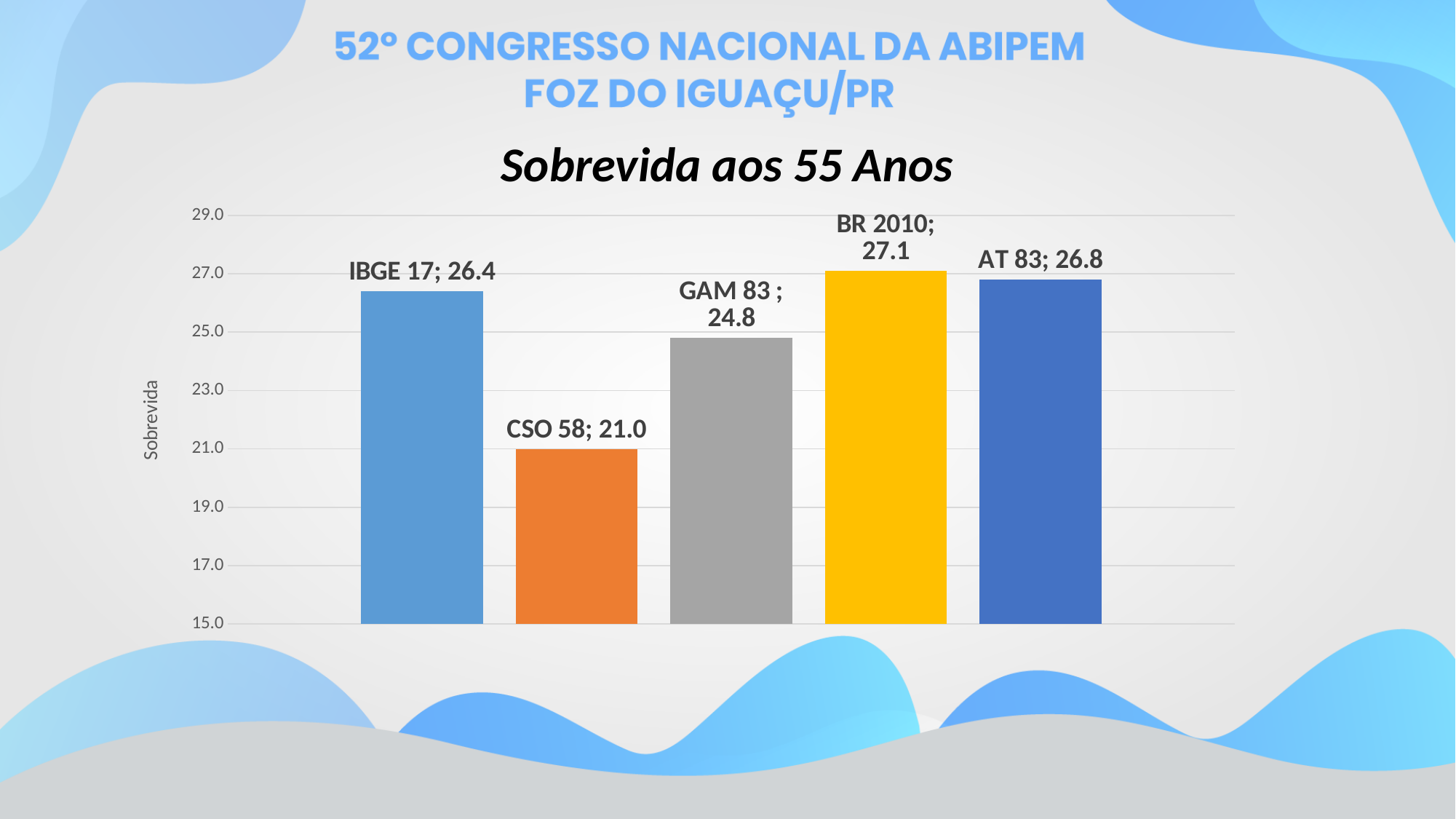
What is the value for AT 83? 26.8 What is the value for IBGE 17? 26.4 Which category has the lowest value? CSO 58 Which category has the highest value? BR 2010 Which is larger, the value for IBGE 17 or the value for GAM 83? IBGE 17 What kind of chart is shown on the slide? bar chart What is the difference between the values for BR 2010 and CSO 58? 6.1 What is the title of the chart? Sobrevida aos 55 Anos How many bars are shown in the chart? 5 What is the value for GAM 83? 24.8 What is the value for BR 2010? 27.1 What is the value for CSO 58? 21.0